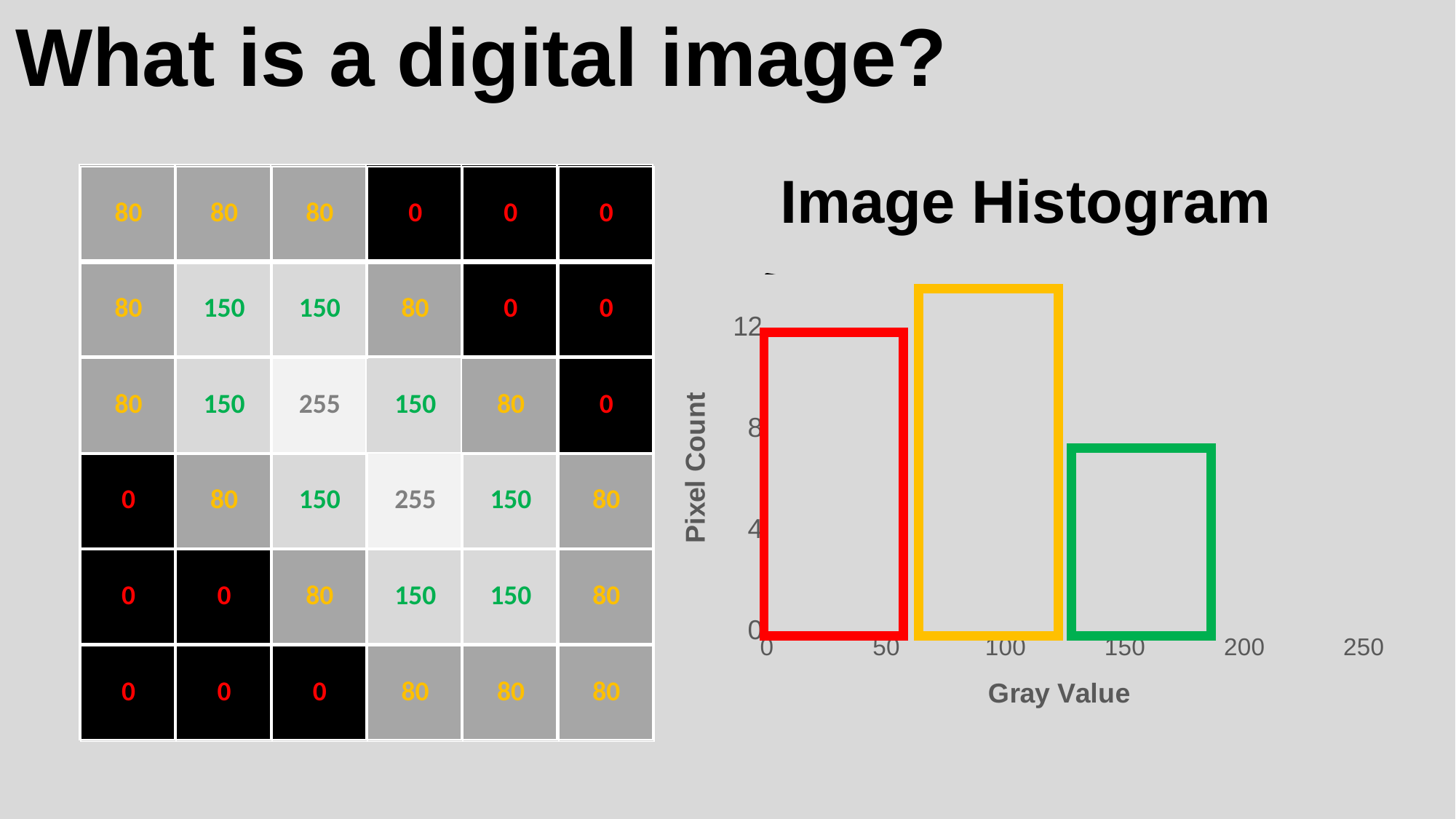
What kind of chart is the Image Histogram? bar chart In the Image Histogram, is the pixel count for the red bar greater or less than 8? greater What is the label of the x axis of the Image Histogram? Gray Value In the Image Histogram, which bar is the tallest: the red, yellow or green one? yellow What is the title of the chart on the right of the slide? Image Histogram In the Image Histogram, is the pixel count for the green bar greater or less than 8? less In the Image Histogram, which bar is the shortest: the red, yellow or green one? green In the Image Histogram, is the pixel count for the yellow bar greater or less than 12? greater In the Image Histogram, what pixel count does the top of the red bar reach on the y axis? 12 How many bars are plotted in the Image Histogram? 3 In the Image Histogram, which bar is taller, the red bar or the green bar? red